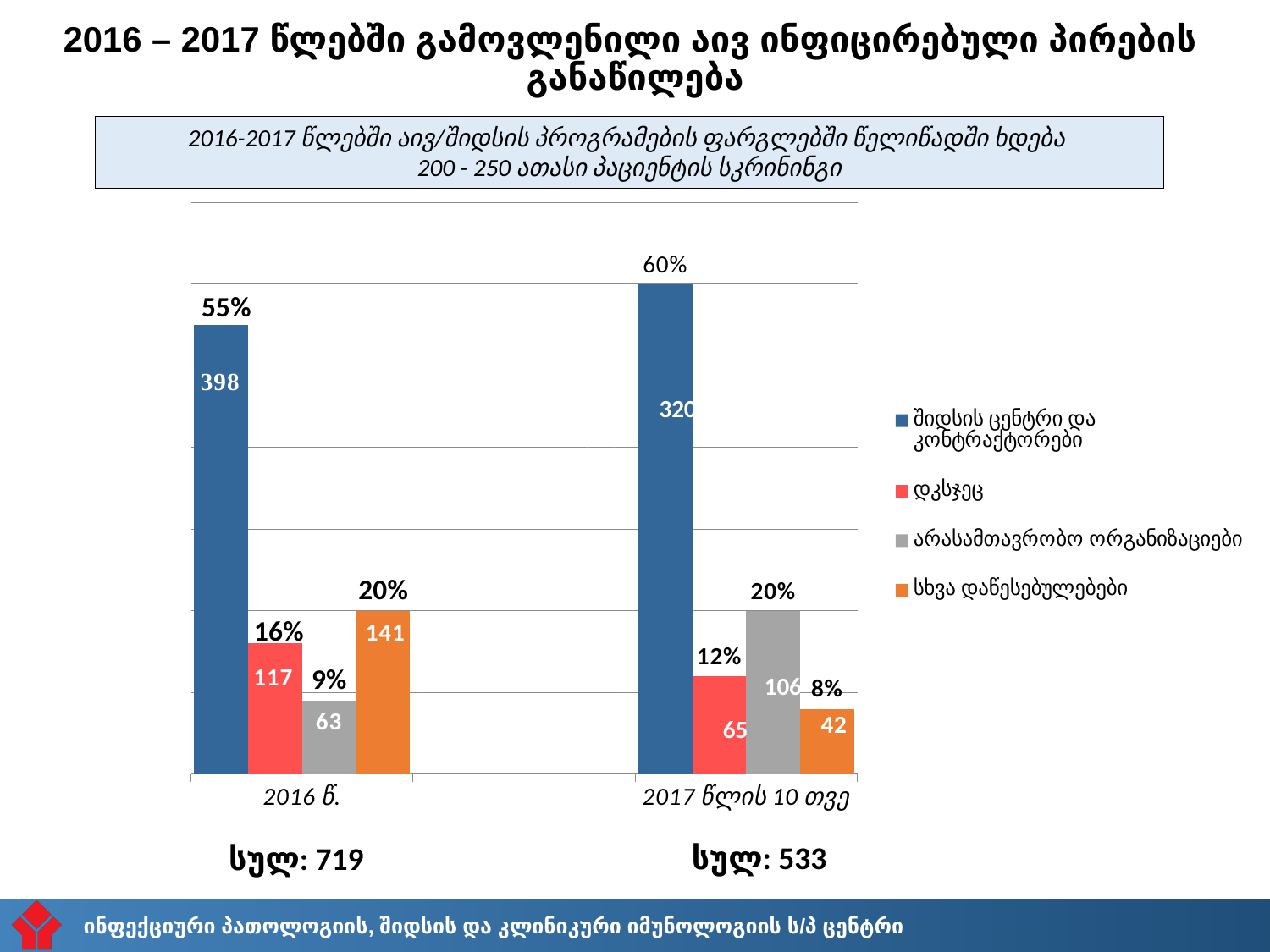
What type of chart is shown on the slide? bar chart What is the value for არასამთავრობო ორგანიზაციები in 2017 წლის 10 თვე? 106 What is the value for სხვა დაწესებულებები in 2016 წ.? 141 What percentage is shown above the შიდსის ცენტრი და კონტრაქტორები bar for 2017 წლის 10 თვე? 60% Which is larger: დკსჯეც in 2016 წ. or დკსჯეც in 2017 წლის 10 თვე? დკსჯეც in 2016 წ. What total is shown below the 2017 წლის 10 თვე group? 533 Which series has the lowest value in 2016 წ.? არასამთავრობო ორგანიზაციები Which series has the highest value in 2017 წლის 10 თვე? შიდსის ცენტრი და კონტრაქტორები How many categories are shown on the x axis? 2 What is the value for შიდსის ცენტრი და კონტრაქტორები in 2016 წ.? 398 How many series does the legend list? 4 What is the difference between the შიდსის ცენტრი და კონტრაქტორები values for 2016 წ. and 2017 წლის 10 თვე? 78